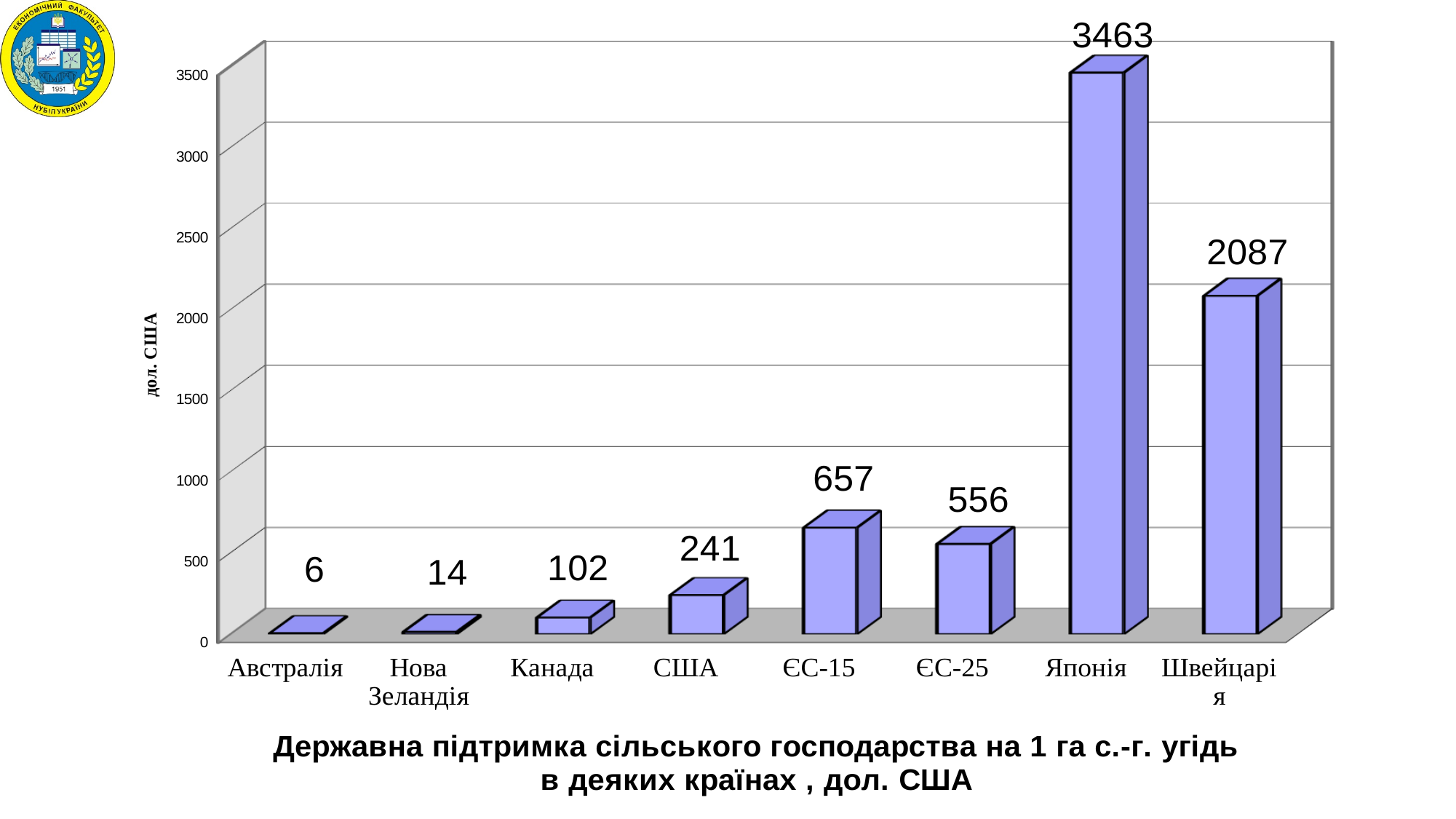
Which country has the lowest value? Австралія What is the value for ЄС-15? 657 How many countries or regions are shown on the x axis? 8 What is the label of the vertical axis? дол. США Which country has the highest value? Японія What is the difference between the values for Японія and Швейцарія? 1376 Which is larger, the value for США or the value for Канада? США Is the value for Швейцарія greater or less than 2000? greater What is the value for Канада? 102 What is the value for Японія? 3463 What is the difference between the values for ЄС-15 and ЄС-25? 101 What kind of chart is shown on the slide? bar chart